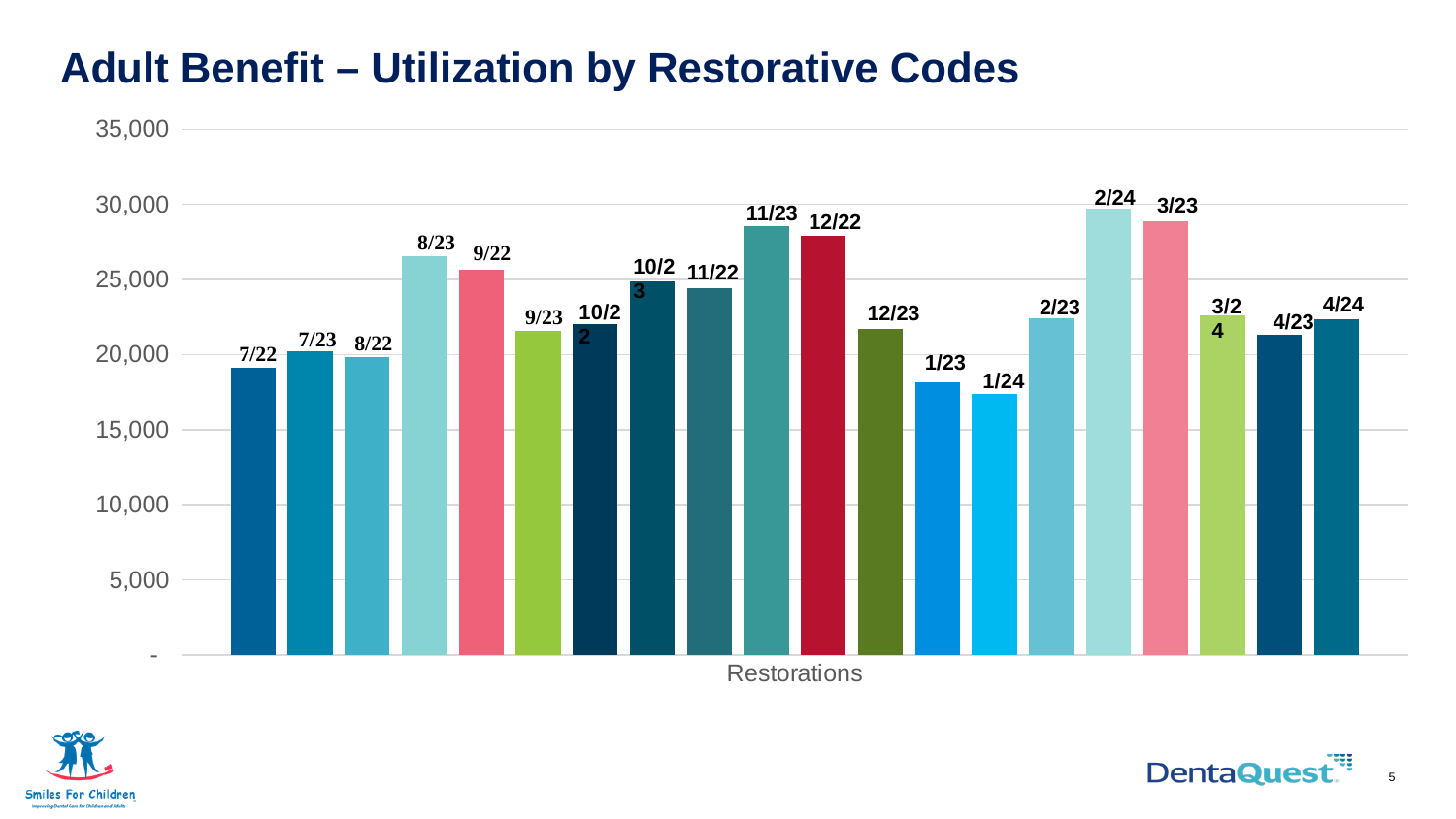
Which bar has the lowest value? 1/24 Which bar has the highest value? 2/24 Is the value for 8/23 greater or less than 25,000? greater What is the title of the chart? Adult Benefit – Utilization by Restorative Codes What label appears under the x axis of the chart? Restorations What kind of chart is shown on the slide? Bar chart Is the value for 7/22 greater or less than 20,000? less Which is larger, the value for 12/22 or the value for 12/23? 12/22 Is the value for 2/24 greater or less than 25,000? greater Which is larger, the value for 9/22 or the value for 9/23? 9/22 How many bars are plotted in the chart? 20